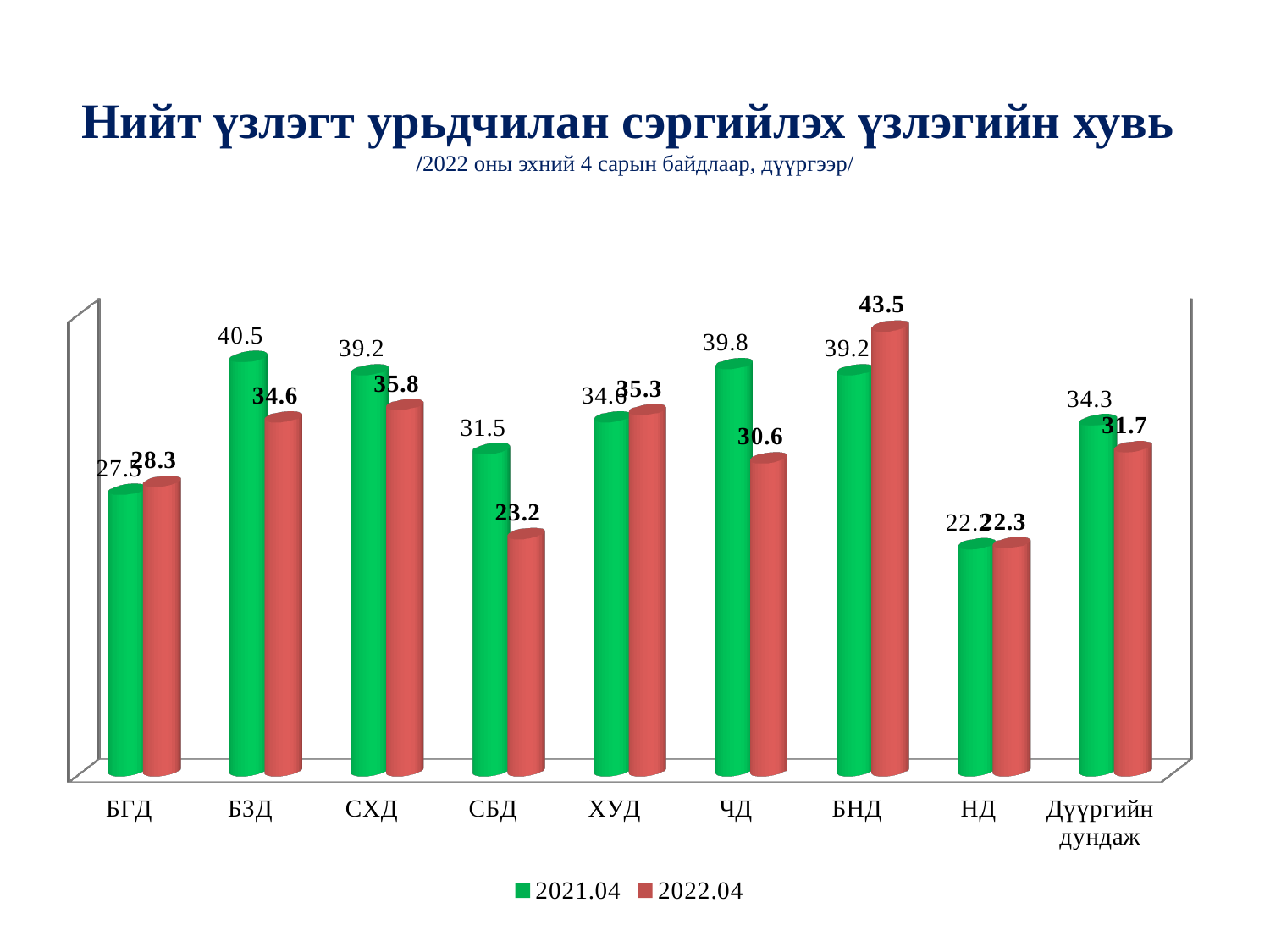
Which category has the highest 2022.04 value? БНД How many series does the legend list? 2 Which is larger for ЧД: the 2021.04 value or the 2022.04 value? 2021.04 Which category has the lowest 2022.04 value? НД What is the 2022.04 value for БНД? 43.5 What is the difference between the 2021.04 and 2022.04 values for СБД? 8.3 What is the 2022.04 value for СБД? 23.2 How many categories are shown on the x axis? 9 What is the 2021.04 value for БЗД? 40.5 What is the 2022.04 value for Дүүргийн дундаж? 31.7 Which colour represents the 2022.04 series? red What kind of chart is shown on the slide? bar chart